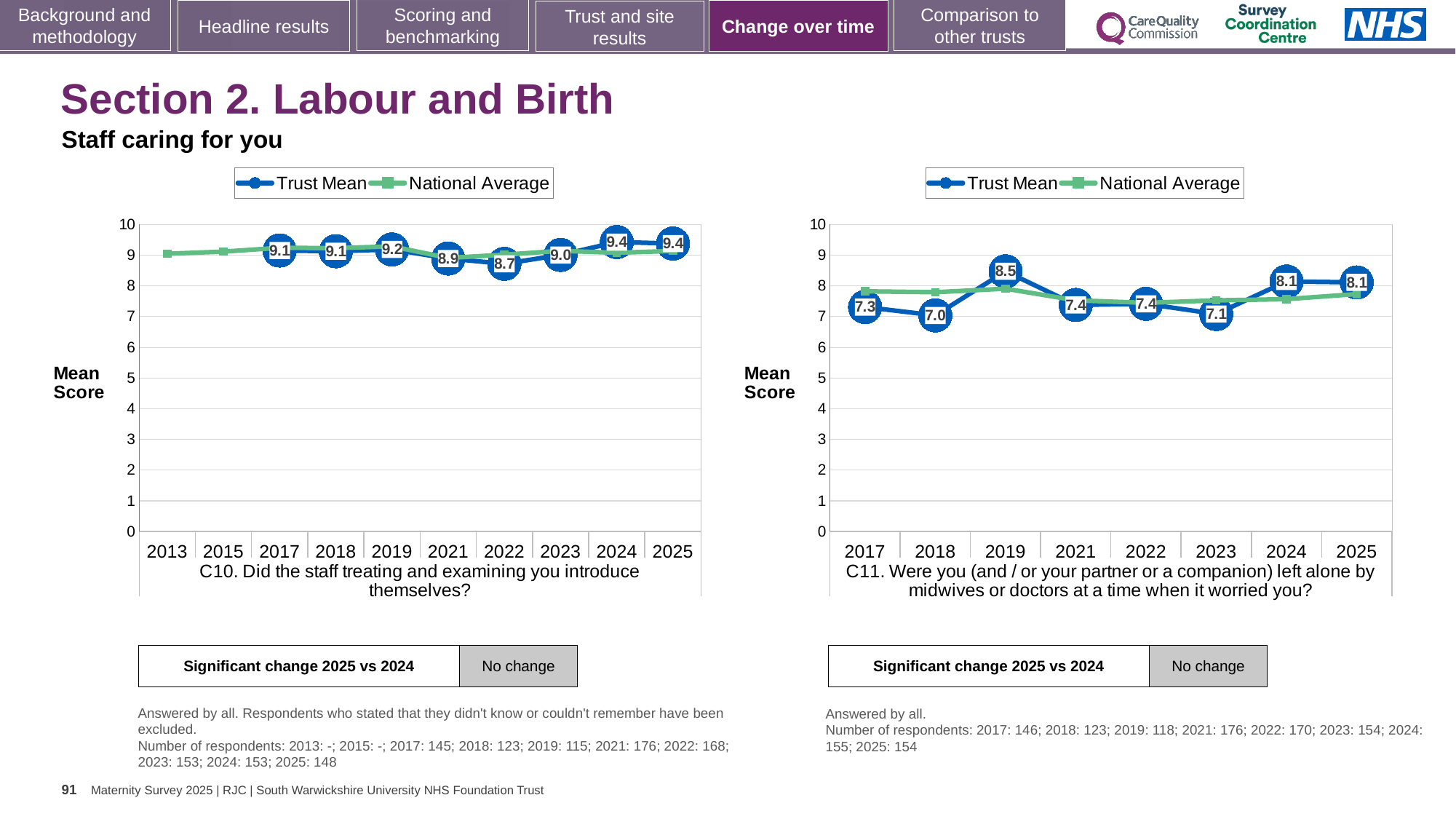
In the C10 chart on the left, what is the Trust Mean score for 2025? 9.4 What kind of chart is the C10 chart on the left? line chart In the C11 chart on the right, is the National Average value for 2017 greater or less than 7? greater In the C10 chart on the left, what is the Trust Mean score for 2022? 8.7 In the C10 chart on the left, is the Trust Mean score for 2019 larger or smaller than the score for 2021? larger How many series does the legend of the C11 chart on the right list? 2 How many years are shown on the x axis of the C10 chart on the left? 10 In the C11 chart on the right, what is the Trust Mean score for 2019? 8.5 In the C11 chart on the right, which year has the lowest Trust Mean score? 2018 In the C11 chart on the right, which year has the highest Trust Mean score? 2019 In the C10 chart on the left, which year has the lowest Trust Mean score? 2022 In the C11 chart on the right, what is the difference between the Trust Mean scores for 2019 and 2018? 1.5